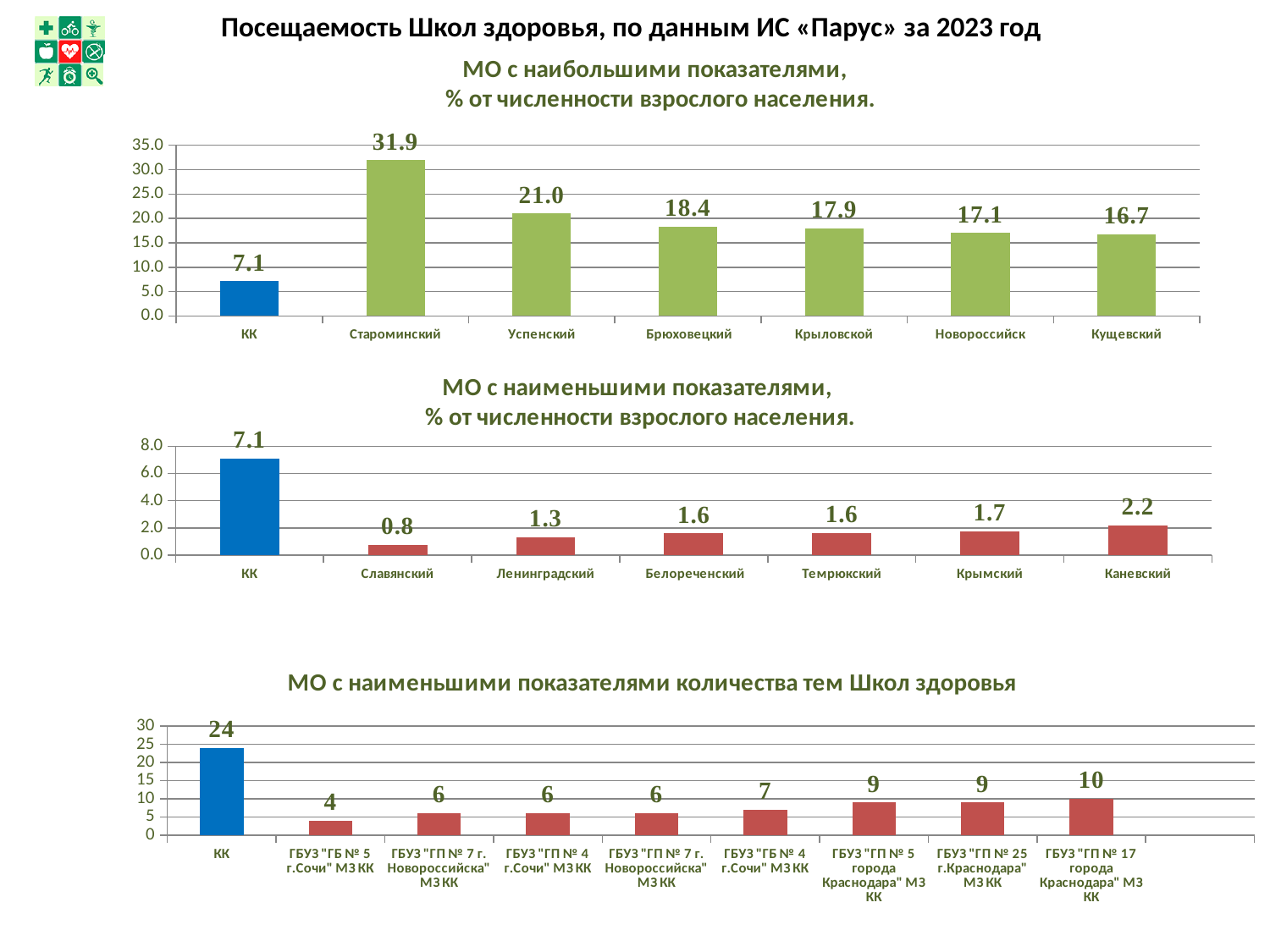
In the middle chart (МО с наименьшими показателями, % от численности взрослого населения), what is the difference between КК and Каневский? 4.9 In the middle chart (МО с наименьшими показателями, % от численности взрослого населения), which category has the lowest value? Славянский In the bottom chart (МО с наименьшими показателями количества тем Школ здоровья), what is the value for КК? 24 In the middle chart (МО с наименьшими показателями, % от численности взрослого населения), which is larger: Каневский or Крымский? Каневский In the top chart (МО с наибольшими показателями), which category has the highest value? Староминский In the bottom chart (МО с наименьшими показателями количества тем Школ здоровья), which category has the lowest value? ГБУЗ "ГБ № 5 г.Сочи" МЗ КК In the top chart (МО с наибольшими показателями), how many bars are plotted? 7 What type of chart is the bottom chart (МО с наименьшими показателями количества тем Школ здоровья)? bar chart In the middle chart (МО с наименьшими показателями, % от численности взрослого населения), what is the value for Славянский? 0.8 In the top chart (МО с наибольшими показателями), what is the difference between Успенский and Кущевский? 4.3 In the top chart (МО с наибольшими показателями), what is the value for Староминский? 31.9 In the bottom chart (МО с наименьшими показателями количества тем Школ здоровья), what is the value for ГБУЗ "ГП № 17 города Краснодара" МЗ КК? 10